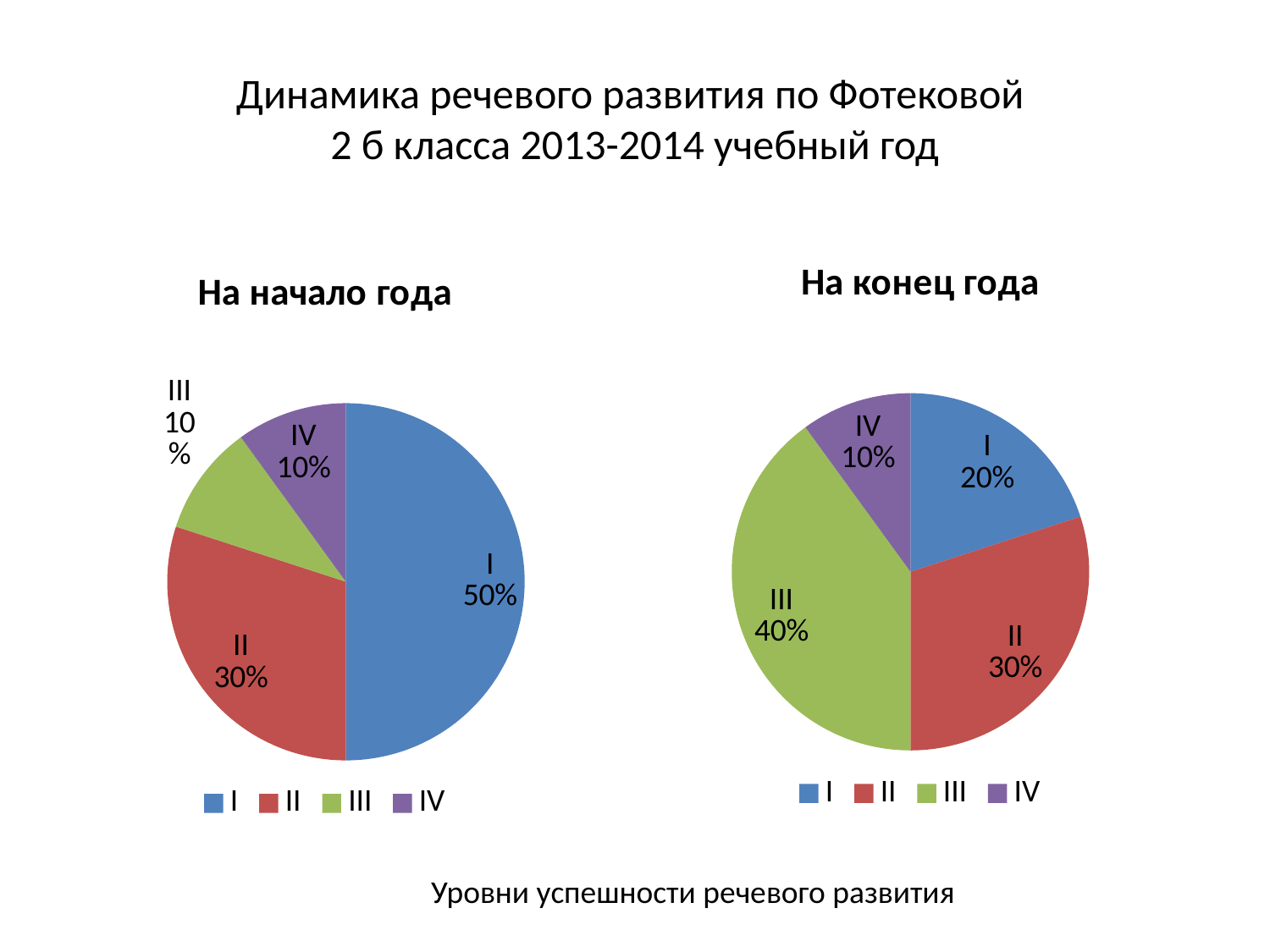
What kind of chart is 'На конец года'? pie chart How many entries does the legend of the 'На конец года' chart list? 4 In the 'На начало года' chart, what is the share for level I? 50% In the 'На начало года' chart, what is the share for level II? 30% In the 'На конец года' chart, what is the difference between the shares of level III and level I? 20% In the 'На конец года' chart, which level has the largest slice? III In the 'На конец года' chart, what is the share for level I? 20% In the 'На начало года' chart, which level has the largest slice? I In the 'На начало года' chart, which is larger: the share for level II or the share for level IV? II How many slices does the 'На начало года' chart have? 4 In the 'На конец года' chart, which level has the smallest slice? IV In the 'На конец года' chart, what is the share for level III? 40%